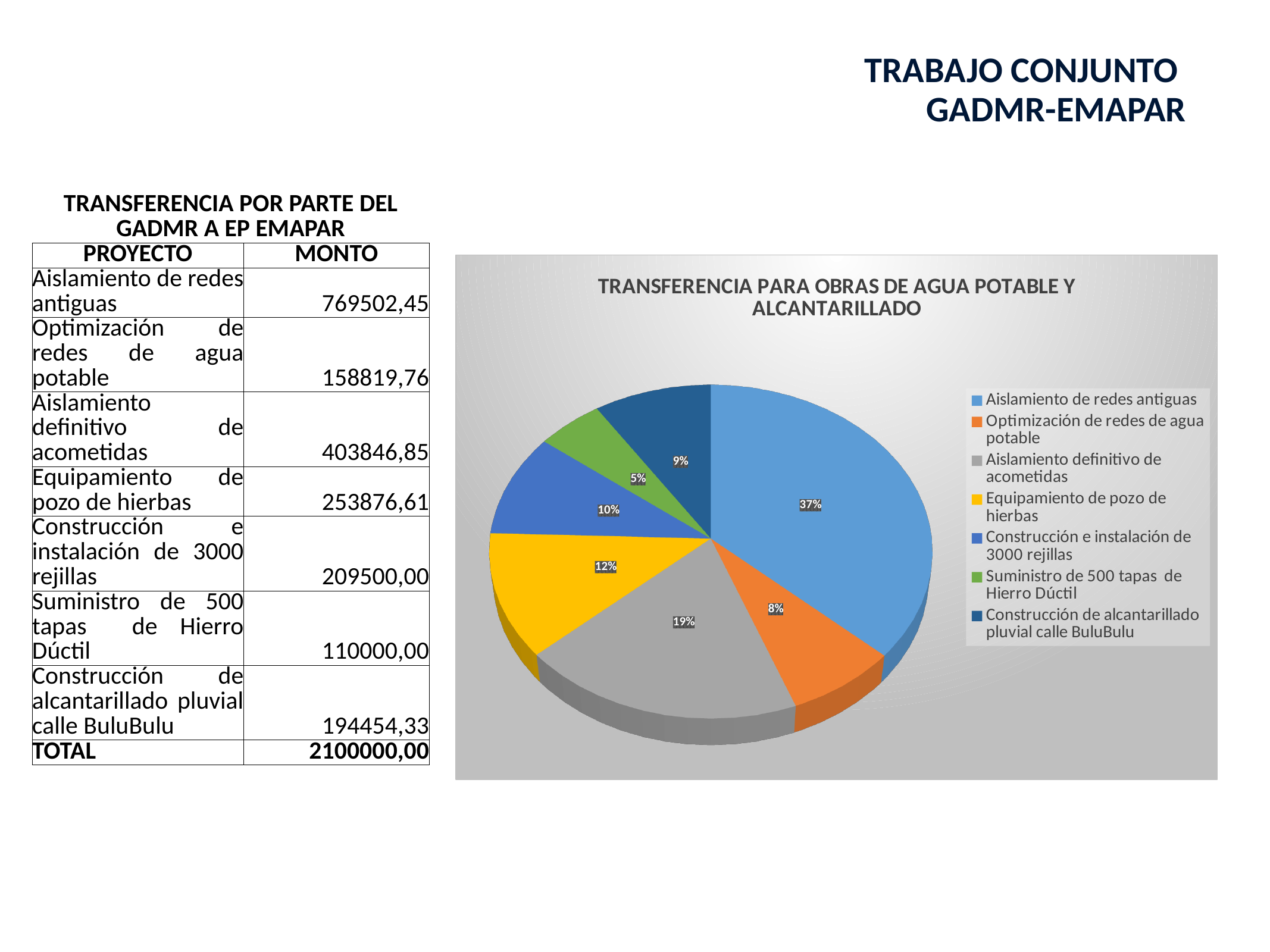
What share of the pie does Construcción de alcantarillado pluvial calle BuluBulu represent? 9% What is the difference in percentage points between the Aislamiento de redes antiguas slice and the Aislamiento definitivo de acometidas slice? 18 percentage points What is the title of the pie chart? TRANSFERENCIA PARA OBRAS DE AGUA POTABLE Y ALCANTARILLADO Which category has the smallest slice of the pie? Suministro de 500 tapas de Hierro Dúctil What share of the pie does Aislamiento de redes antiguas represent? 37% What share of the pie does Aislamiento definitivo de acometidas represent? 19% What kind of chart is shown on the slide? Pie chart Which category has the largest slice of the pie? Aislamiento de redes antiguas How many slices does the pie chart have? 7 Which slice is larger: Optimización de redes de agua potable or Construcción e instalación de 3000 rejillas? Construcción e instalación de 3000 rejillas